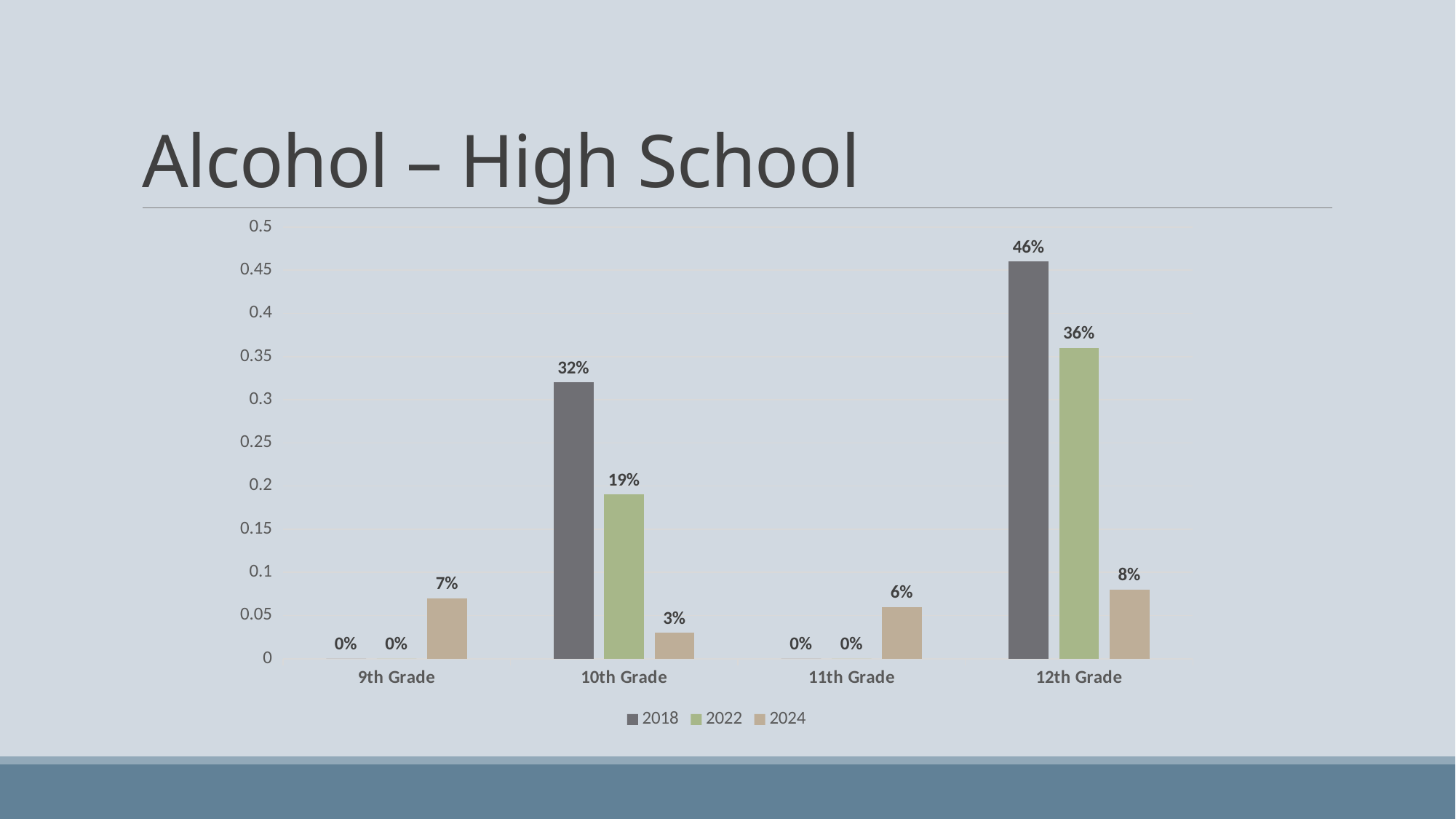
Which grade has the lowest 2024 value? 10th Grade What kind of chart is shown on the slide? Bar chart What is the 2018 value for 12th Grade? 46% How many series does the legend list? 3 What is the 2022 value for 10th Grade? 19% What is the 2024 value for 11th Grade? 6% What is the difference between the 2018 and 2022 values for 12th Grade? 10% How many grade categories are shown on the x axis? 4 Which grade has the highest 2018 value? 12th Grade Which is larger for 10th Grade, the 2018 value or the 2022 value? 2018 What is the difference between the 2018 and 2024 values for 10th Grade? 29% What is the 2024 value for 9th Grade? 7%